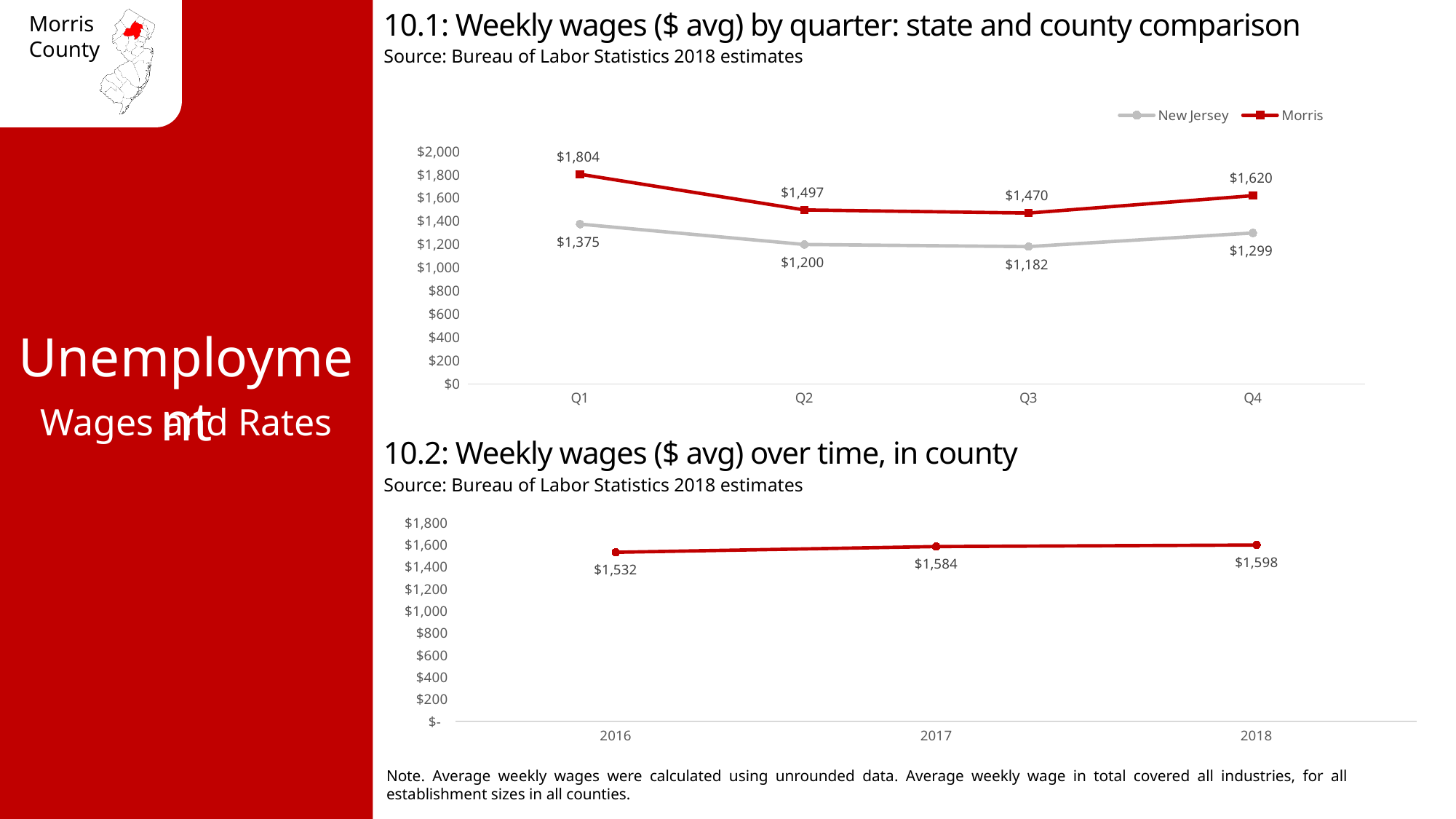
In chart 10.1 (weekly wages by quarter), how many series does the legend list? 2 In chart 10.1 (weekly wages by quarter), what is the New Jersey value for Q3? $1,182 In chart 10.1 (weekly wages by quarter), what kind of chart is shown? Line chart In chart 10.2 (weekly wages over time, in county), what is the difference between the 2018 and 2016 values? $66 In chart 10.1 (weekly wages by quarter), which quarter has the lowest Morris value? Q3 In chart 10.2 (weekly wages over time, in county), what is the value for 2017? $1,584 In chart 10.1 (weekly wages by quarter), which series has the higher value in Q2, New Jersey or Morris? Morris In chart 10.1 (weekly wages by quarter), what is the difference between the Morris and New Jersey values in Q4? $321 In chart 10.1 (weekly wages by quarter), which quarter has the highest New Jersey value? Q1 In chart 10.1 (weekly wages by quarter), what is the Morris value for Q1? $1,804 In chart 10.2 (weekly wages over time, in county), how many years are plotted? 3 In chart 10.2 (weekly wages over time, in county), do the values rise or fall from 2016 to 2018? Rise